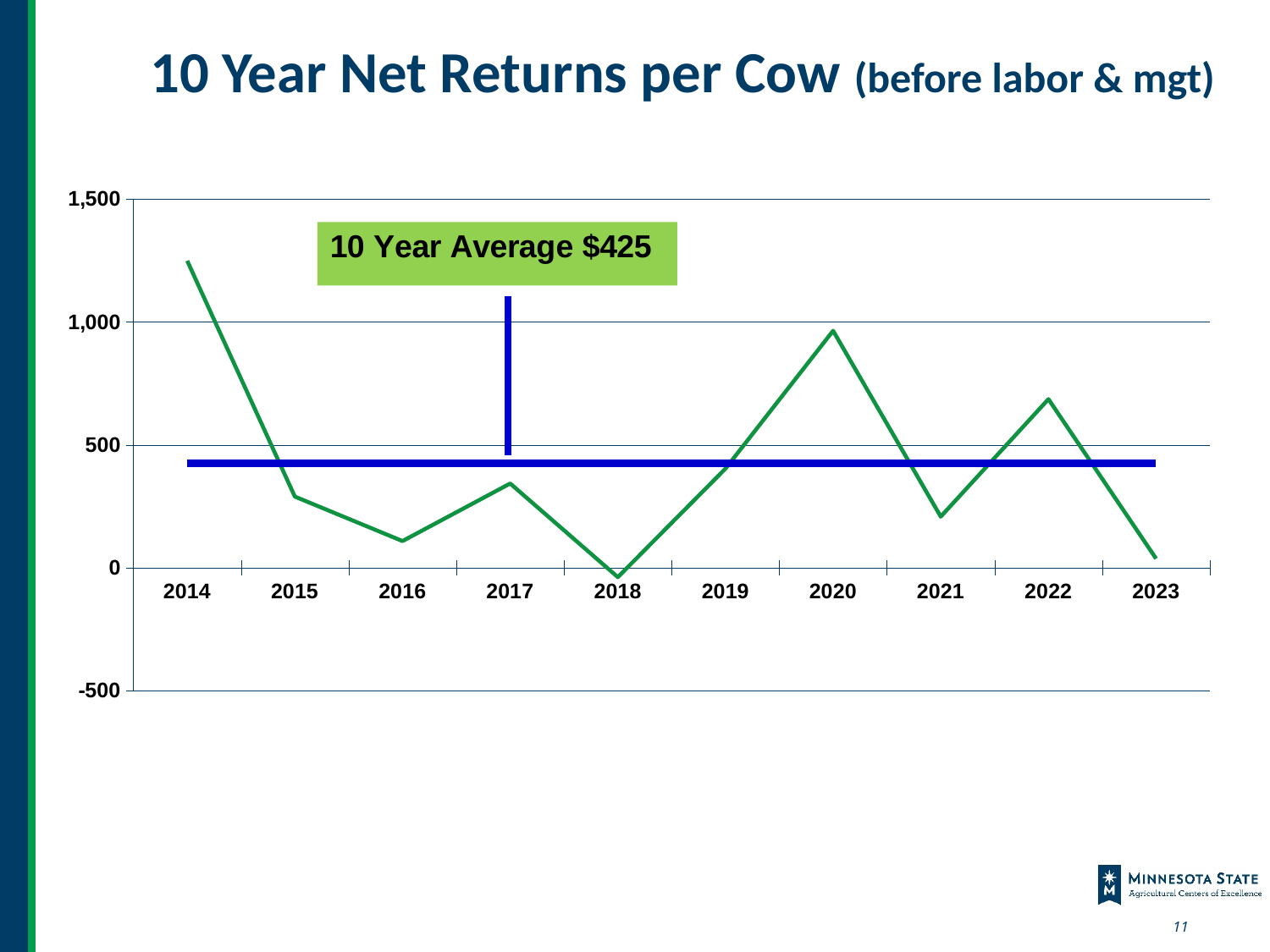
Do the net returns per cow rise or fall from 2014 to 2016? fall Which year has the larger net return per cow, 2014 or 2020? 2014 Which year has the highest net return per cow? 2014 Which year has the lowest net return per cow? 2018 Is the net return per cow for 2016 greater or less than 500? less What is the title of the chart on the slide? 10 Year Net Returns per Cow (before labor & mgt) What is the 10 year average net return per cow shown on the chart? $425 How many years are plotted on the x axis of the chart? 10 Is the net return per cow for 2020 greater or less than 1,000? less Is the net return per cow for 2014 greater or less than 1,000? greater What kind of chart is shown on the slide? line chart